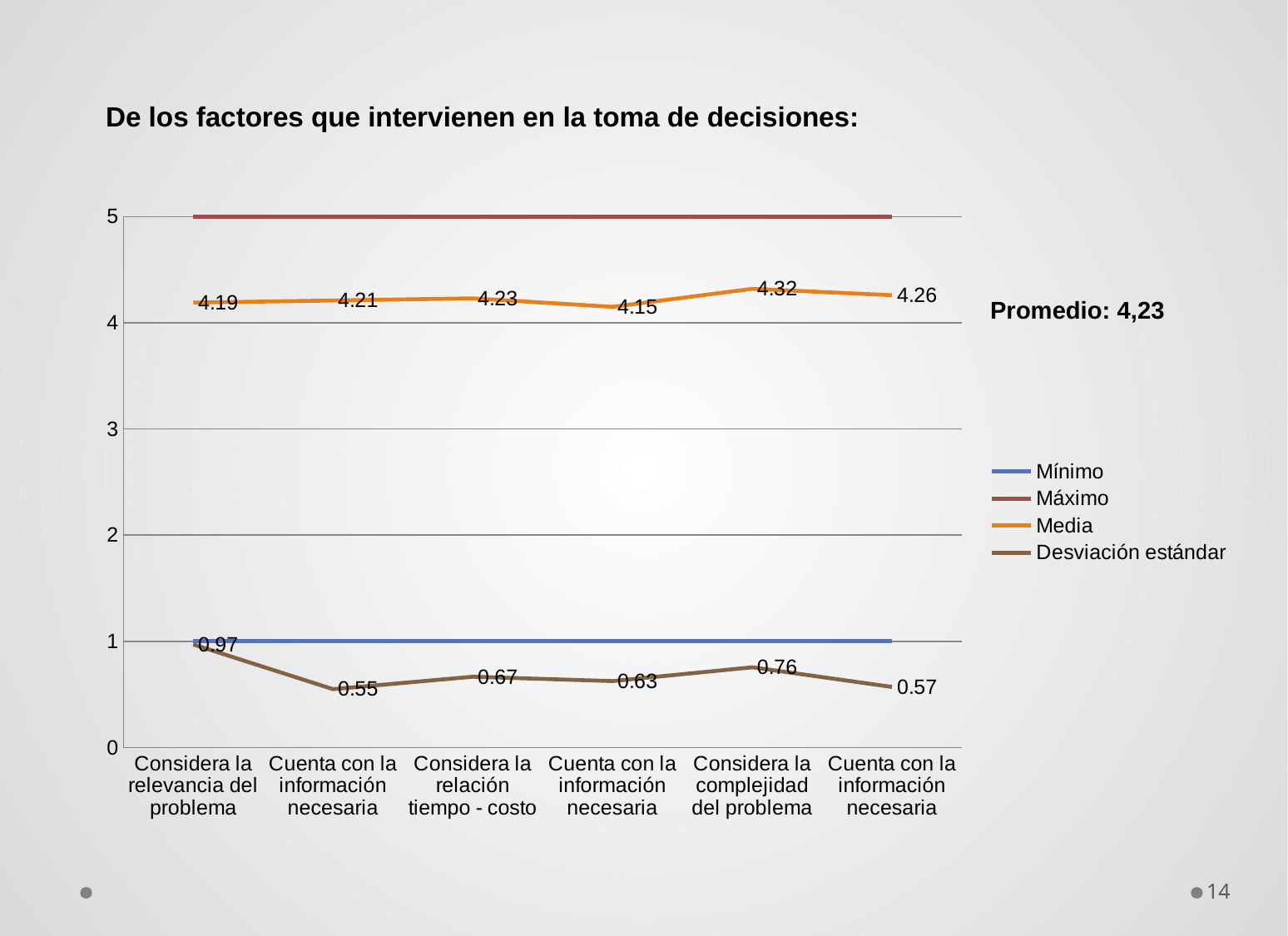
How many series does the legend list? 4 Which has the larger Desviación estándar: 'Considera la relevancia del problema' or 'Considera la relación tiempo - costo'? Considera la relevancia del problema What is the Media value for 'Considera la complejidad del problema'? 4.32 What kind of chart is shown on the slide? line chart What is the Desviación estándar value for 'Considera la relevancia del problema'? 0.97 What is the difference between the Media values for 'Considera la complejidad del problema' and 'Considera la relevancia del problema'? 0.13 At what value does the Máximo line sit across all categories? 5 What Promedio value is printed next to the chart? 4,23 What is the lowest Media value shown on the chart? 4.15 Which category has the highest Media value? Considera la complejidad del problema How many categories are plotted along the x axis? 6 What is the Media value for the last category on the x axis? 4.26